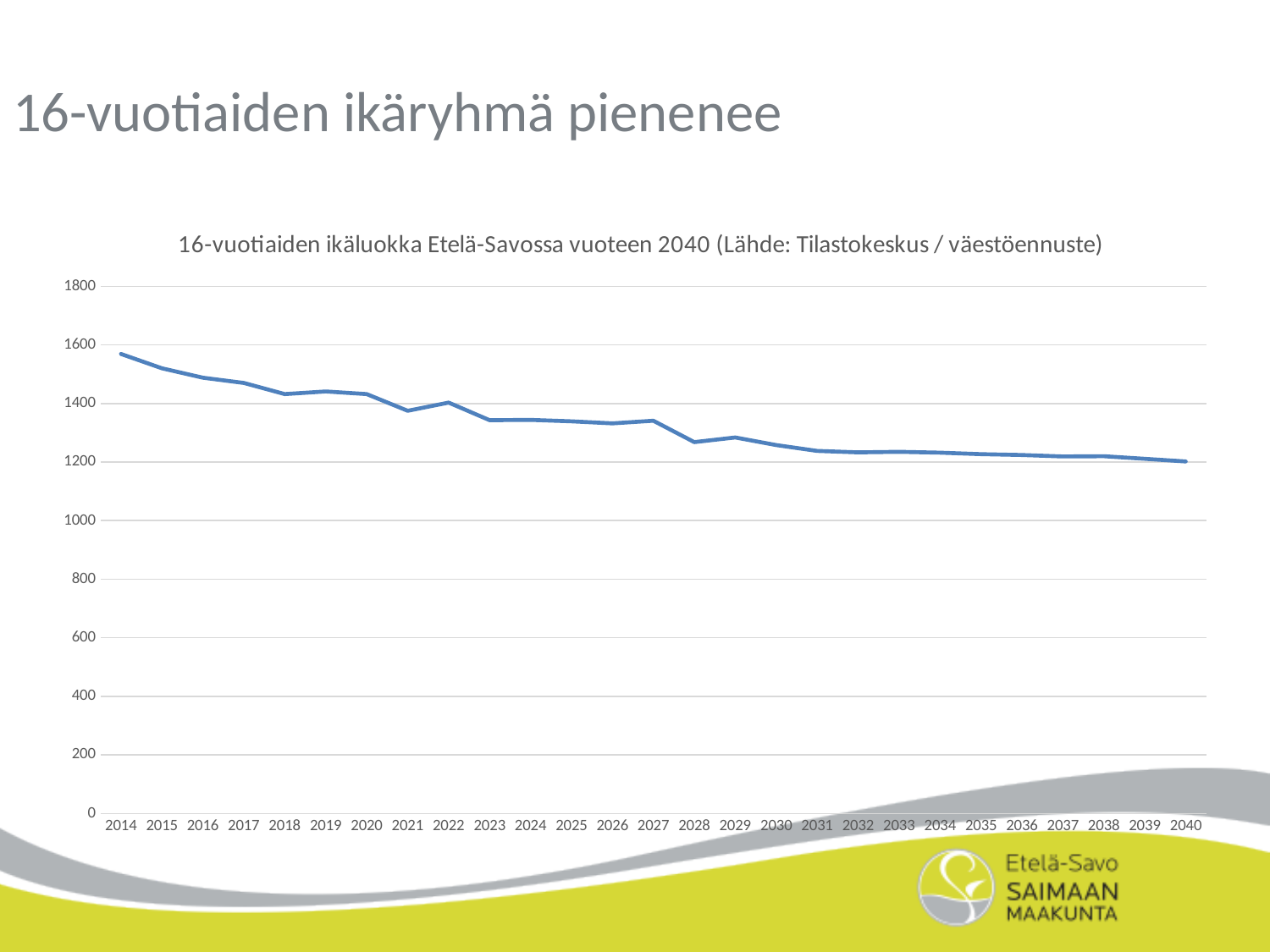
Which is larger, the value for 2018 or the value for 2030? 2018 What is the title of the chart? 16-vuotiaiden ikäluokka Etelä-Savossa vuoteen 2040 (Lähde: Tilastokeskus / väestöennuste) Is the value for 2028 greater or less than 1400? less What kind of chart is shown on the slide? line chart Which year has the highest value? 2014 Do the values rise or fall from 2014 to 2040? fall Is the value for 2035 greater or less than 1000? greater What is the first year shown on the x axis? 2014 Which year has the lowest value? 2040 How many years are plotted along the x axis? 27 Is the value for 2040 greater or less than 1400? less